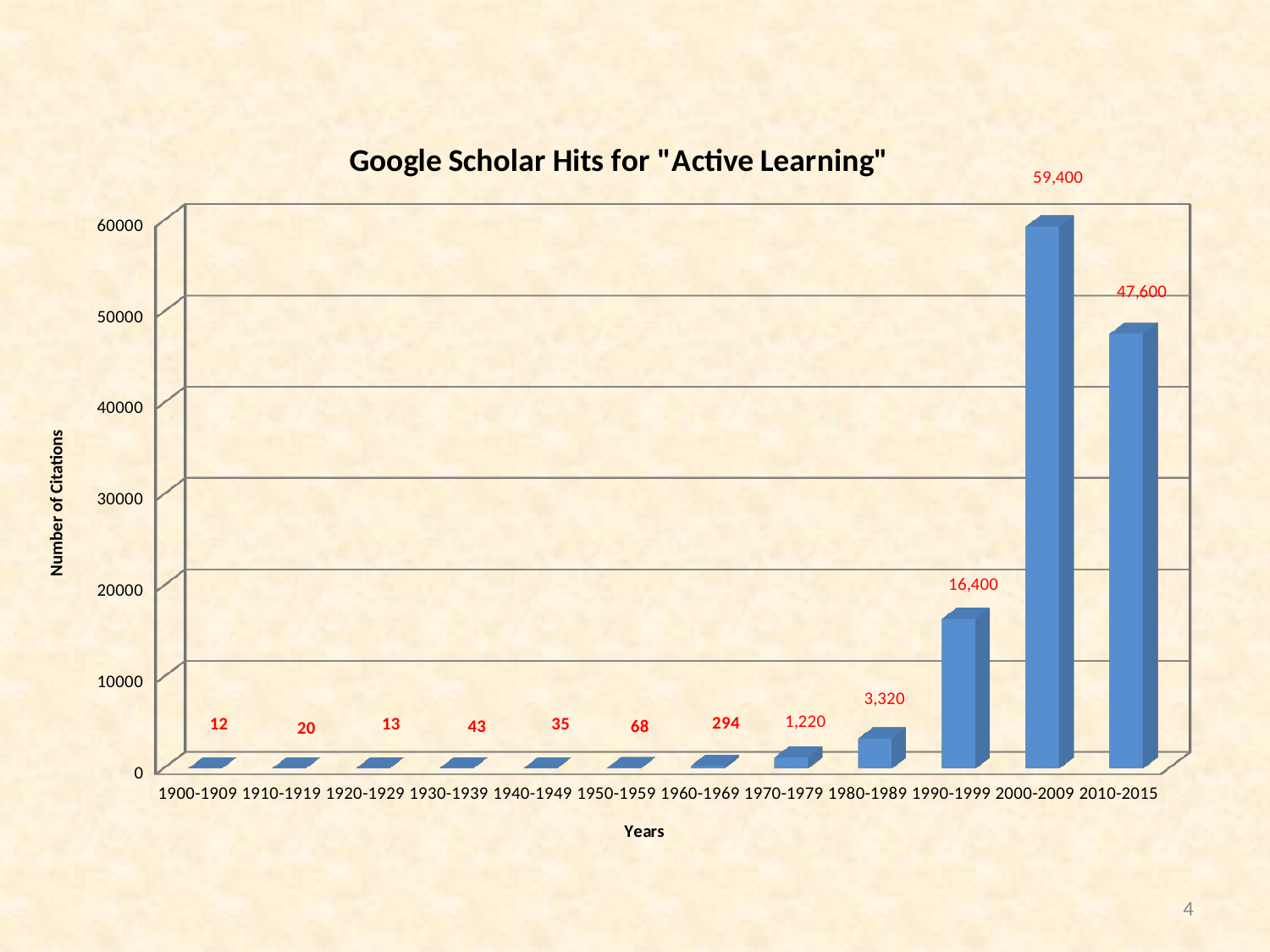
How many year periods are shown on the x axis? 12 Which period has more citations, 1980-1989 or 1990-1999? 1990-1999 What is the number of citations for 1990-1999? 16,400 What is the number of citations for 1900-1909? 12 What kind of chart is shown on the slide? bar chart Is the value for 2010-2015 greater or less than 50000? less What is the difference in citations between 2000-2009 and 2010-2015? 11,800 Which period has the lowest number of citations? 1900-1909 What is the title of the chart? Google Scholar Hits for "Active Learning" Which period has the highest number of citations? 2000-2009 What is the number of citations for 1970-1979? 1,220 What is the number of citations for 2000-2009? 59,400